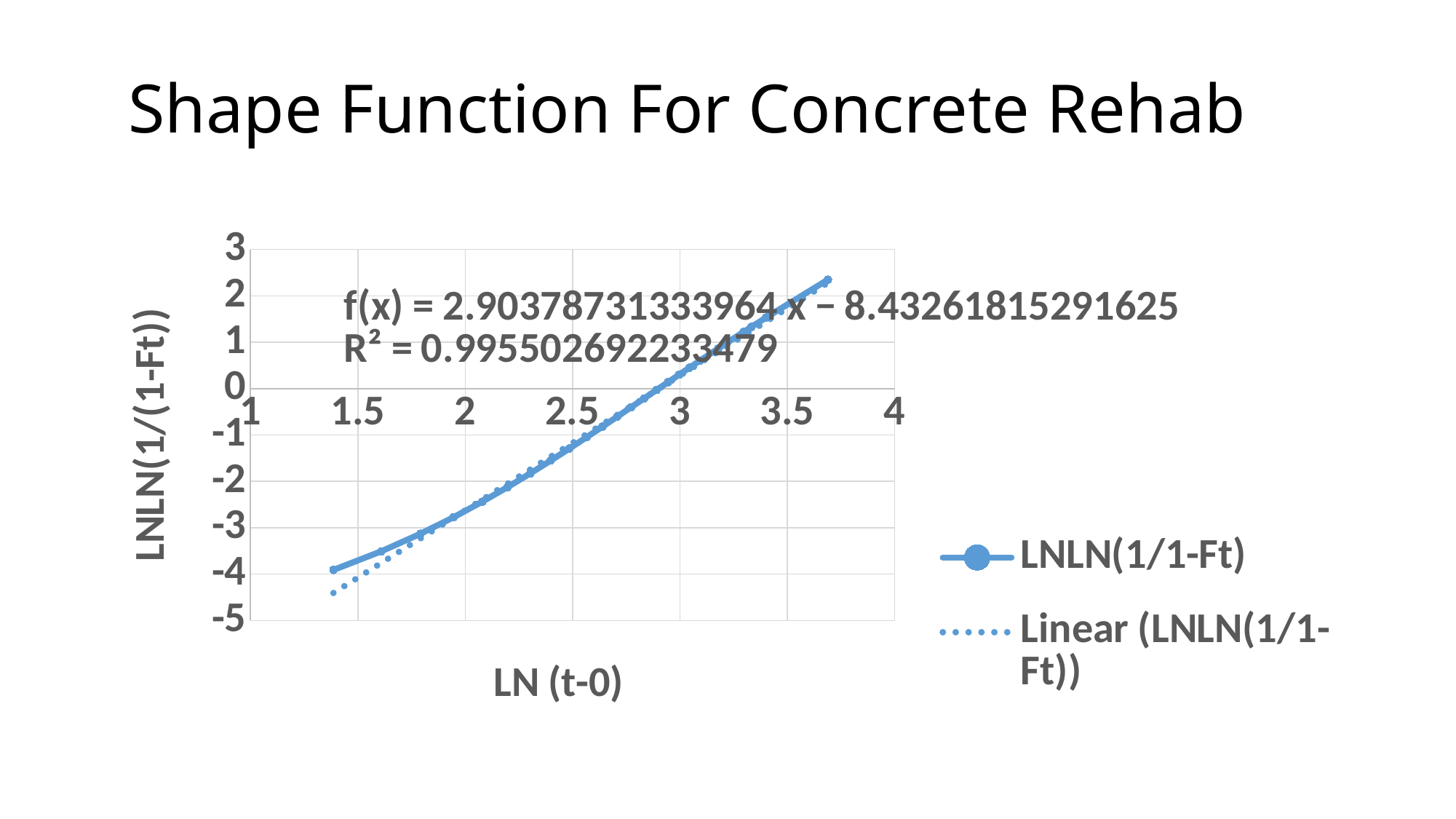
Is the value of LNLN(1/1-Ft) at LN (t-0) = 2.5 greater or less than 0? less What kind of chart is shown on the slide? line chart Is the value of LNLN(1/1-Ft) at LN (t-0) = 2 greater or less than -2? less How many series does the legend list? 2 Which is larger, the value of LNLN(1/1-Ft) at LN (t-0) = 2 or at LN (t-0) = 3? at LN (t-0) = 3 Do the values of LNLN(1/1-Ft) rise or fall as LN (t-0) increases? rise Is the value of LNLN(1/1-Ft) at LN (t-0) = 3.5 greater or less than 1? greater What is the R² value shown on the chart? R² = 0.995502692233479 What is the trendline equation shown on the chart? f(x) = 2.90378731333964 x − 8.43261815291625